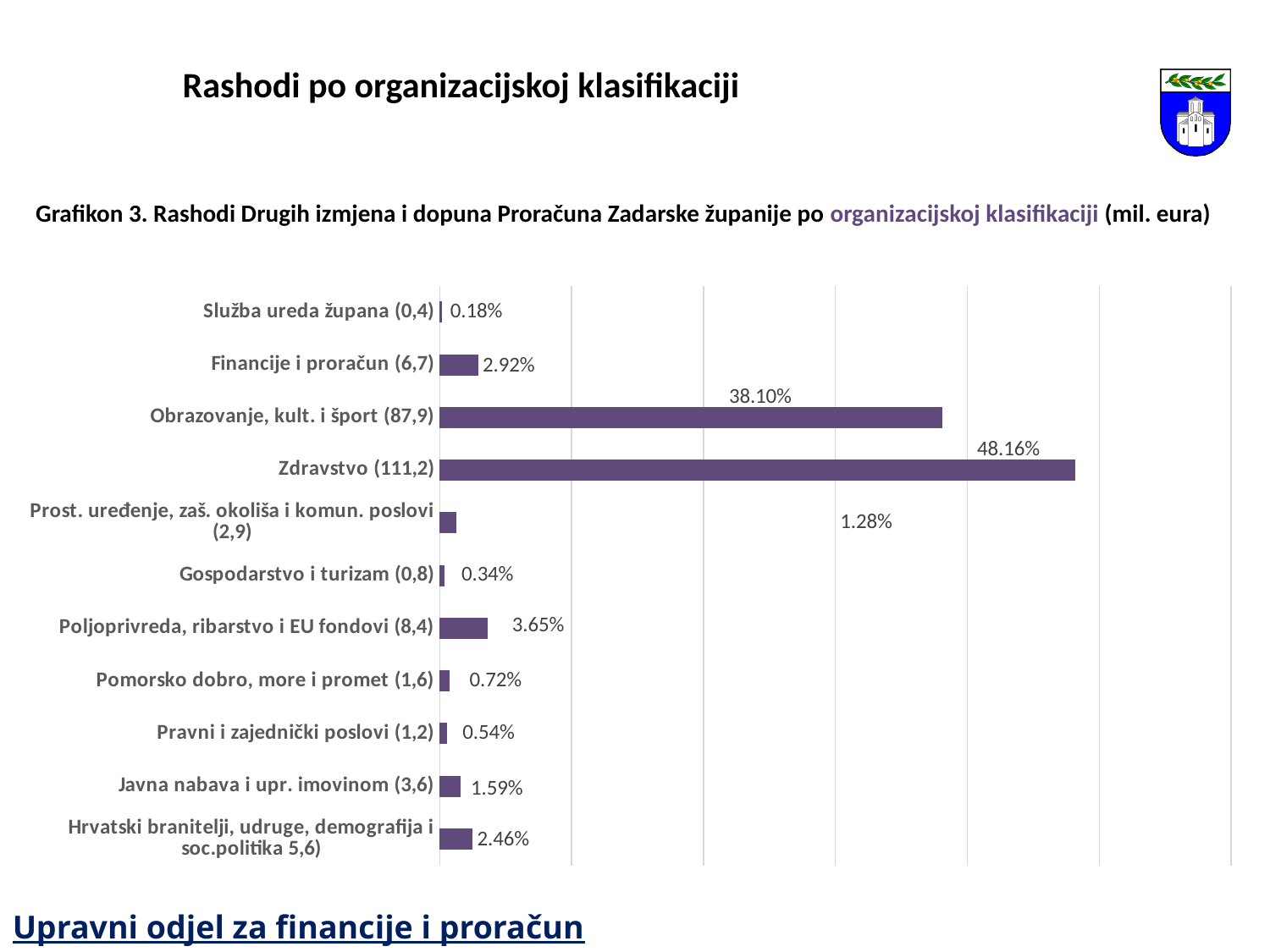
Which category has the lowest value in the chart? Služba ureda župana (0,4) What is the value shown for Zdravstvo (111,2)? 48.16% How many categories are plotted in the chart? 11 What is the value shown for Obrazovanje, kult. i šport (87,9)? 38.10% Which category has the highest value in the chart? Zdravstvo (111,2) What is the difference between the values for Javna nabava i upr. imovinom (3,6) and Pravni i zajednički poslovi (1,2)? 1.05% What is the value shown for Poljoprivreda, ribarstvo i EU fondovi (8,4)? 3.65% What is the difference between the values for Zdravstvo (111,2) and Obrazovanje, kult. i šport (87,9)? 10.06% What kind of chart is shown on the slide? bar chart What is the value shown for Služba ureda župana (0,4)? 0.18% What is the title of the chart on the slide? Grafikon 3. Rashodi Drugih izmjena i dopuna Proračuna Zadarske županije po organizacijskoj klasifikaciji (mil. eura) Which is larger, the value for Financije i proračun (6,7) or the value for Hrvatski branitelji, udruge, demografija i soc.politika 5,6)? Financije i proračun (6,7)